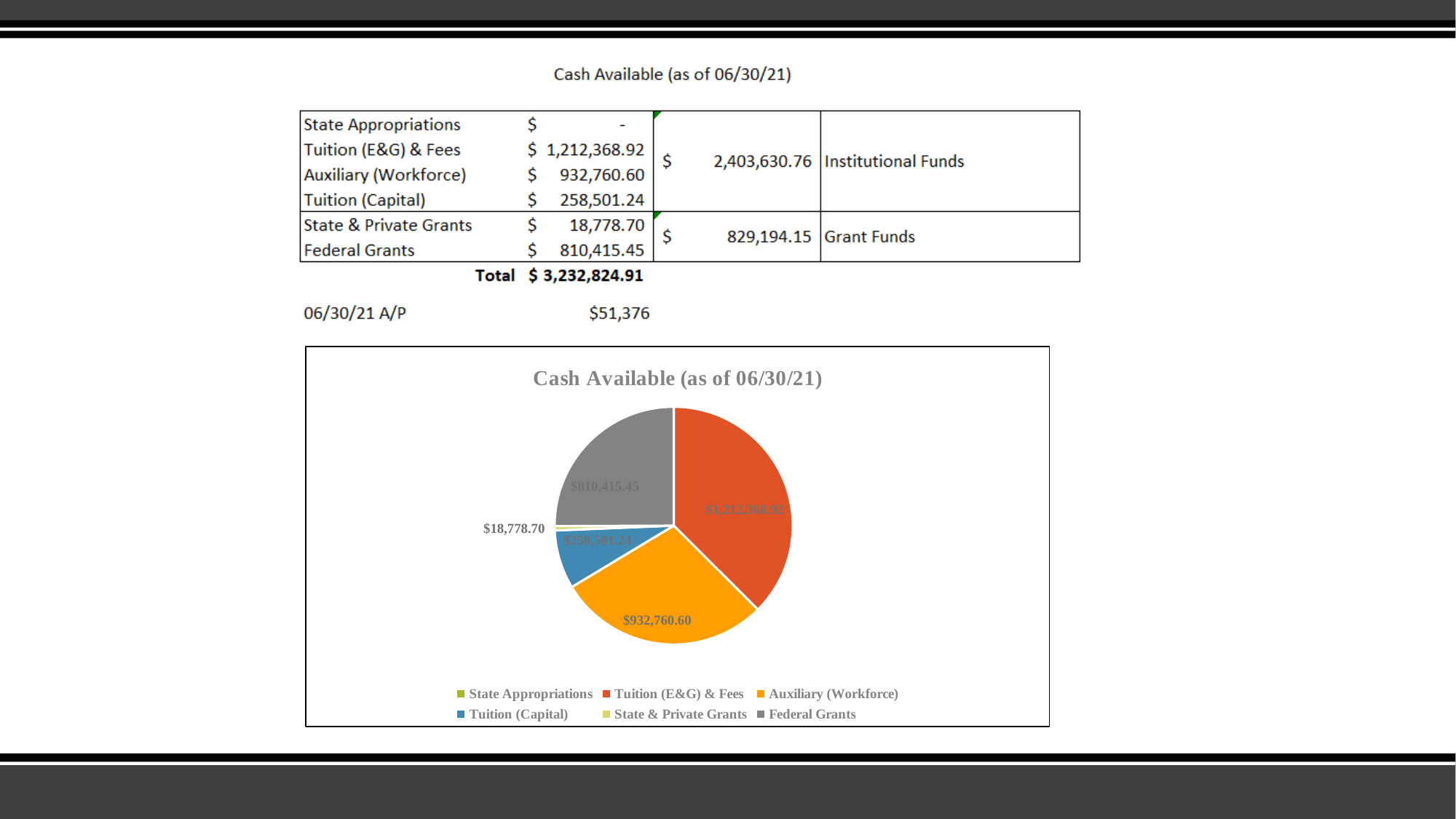
Which category has the largest slice in the pie chart? Tuition (E&G) & Fees What kind of chart is shown on the slide? Pie chart What is the title of the chart? Cash Available (as of 06/30/21) What is the value shown for State & Private Grants in the pie chart? $18,778.70 How many categories does the legend of the pie chart list? 6 What is the value shown for Tuition (E&G) & Fees in the pie chart? $1,212,368.92 What is the difference between the Tuition (E&G) & Fees value and the Auxiliary (Workforce) value in the pie chart? $279,608.32 Which is larger in the pie chart, Auxiliary (Workforce) or Federal Grants? Auxiliary (Workforce) What is the value shown for Auxiliary (Workforce) in the pie chart? $932,760.60 What is the value shown for Tuition (Capital) in the pie chart? $258,501.24 What is the difference between the Federal Grants value and the Tuition (Capital) value in the pie chart? $551,914.21 What is the value shown for Federal Grants in the pie chart? $810,415.45